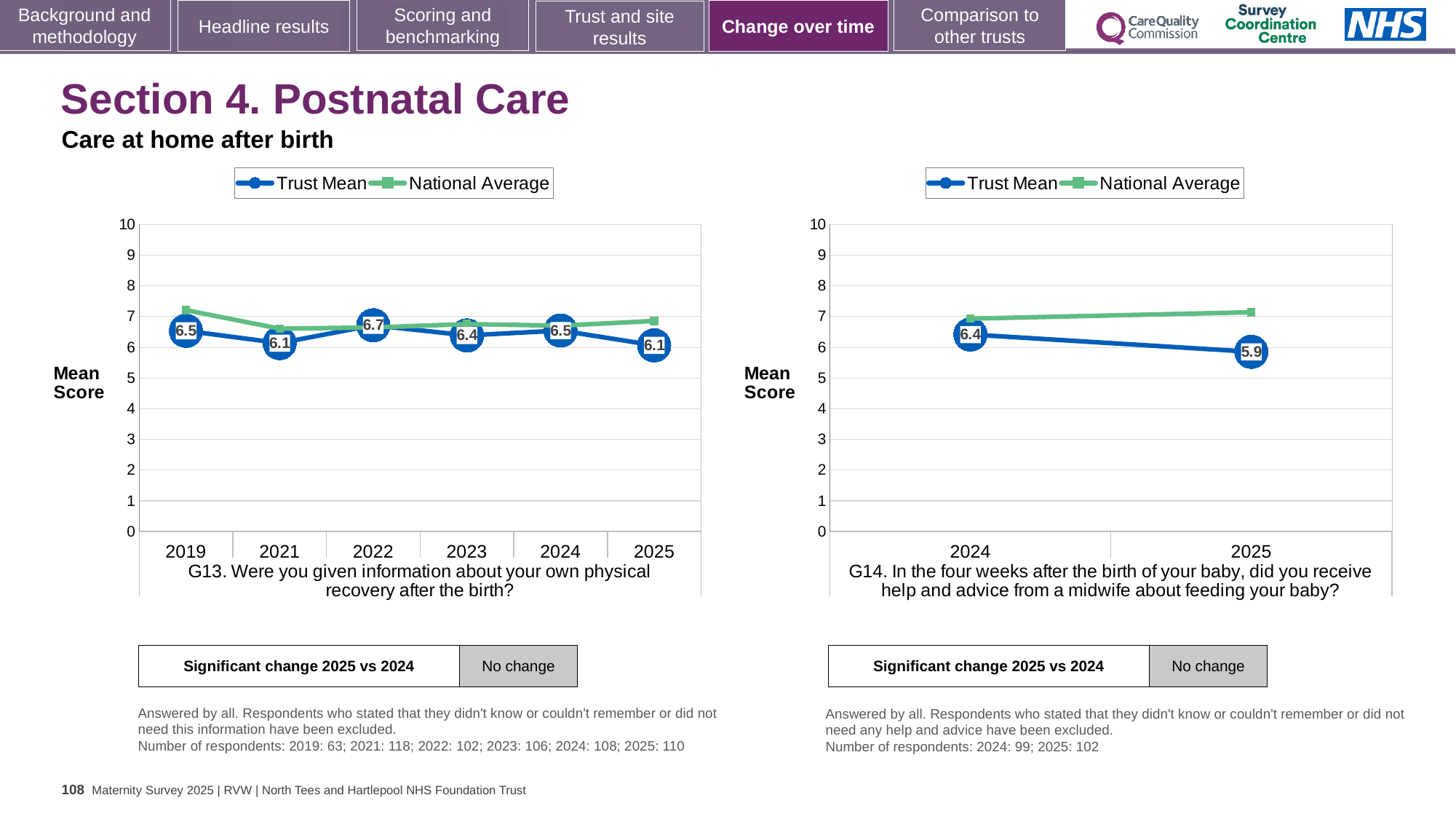
In the G13 chart, is the Trust Mean score for 2022 or 2023 larger? 2022 In the G14 chart, what is the Trust Mean score for 2024? 6.4 In the G13 chart, which year has the highest Trust Mean score? 2022 In the G14 chart, what is the difference between the Trust Mean scores for 2024 and 2025? 0.5 In the G14 chart, which year has the lowest Trust Mean score? 2025 In the G14 chart, does the Trust Mean rise or fall from 2024 to 2025? fall In the G14 chart, what is the Trust Mean score for 2025? 5.9 In the G13 chart, what is the Trust Mean score for 2022? 6.7 How many series does the legend of the G14 chart list? 2 In the G13 chart, what is the Trust Mean score for 2025? 6.1 How many years are plotted on the x axis of the G13 chart? 6 In the G14 chart, is the National Average value for 2025 greater or less than 6? greater